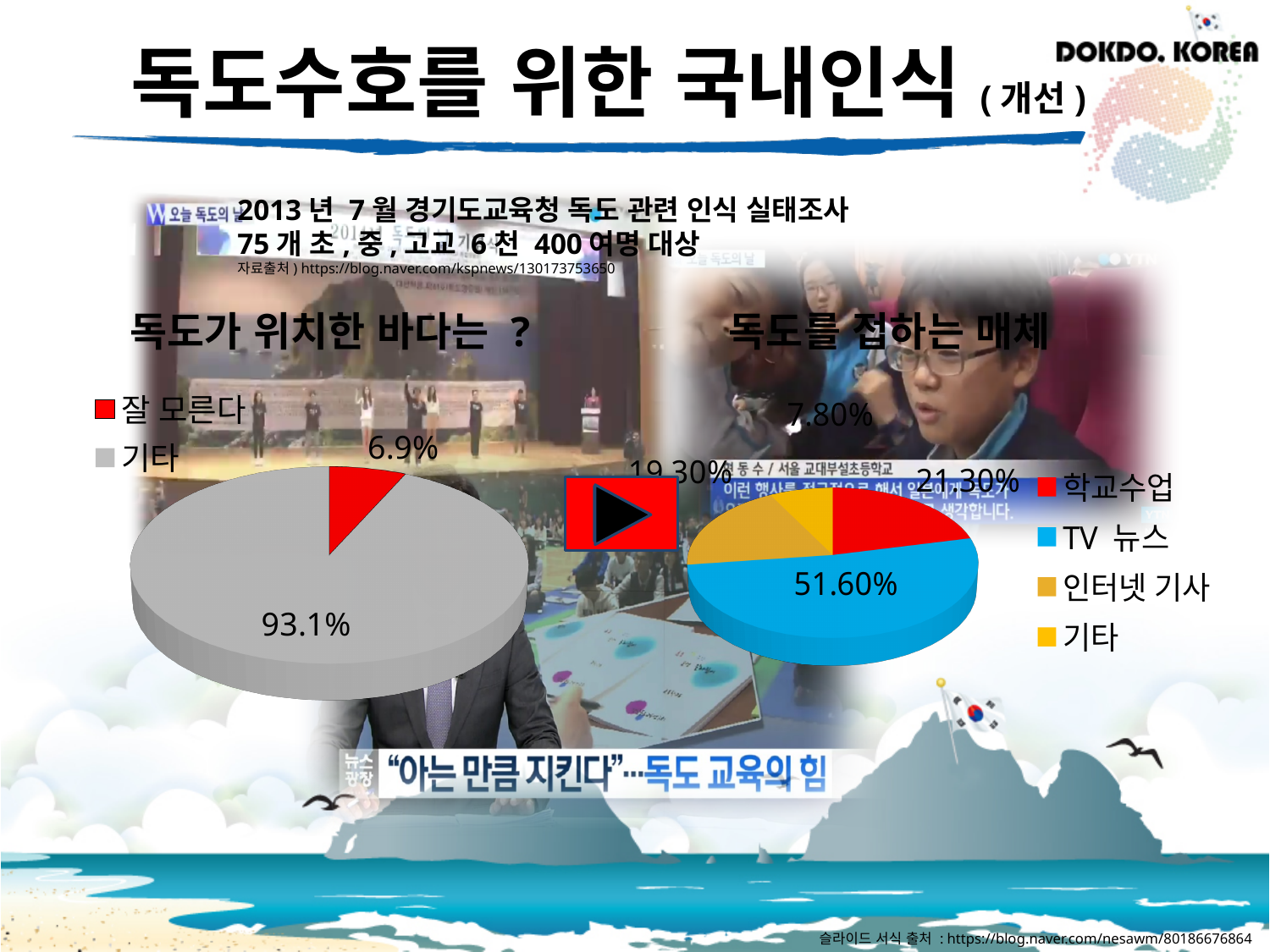
In the right pie chart titled '독도를 접하는 매체', what percentage is shown for '학교수업'? 21.30% In the left pie chart titled '독도가 위치한 바다는 ?', what is the difference between the '기타' and '잘 모른다' shares? 86.2% In the right pie chart titled '독도를 접하는 매체', which category has the smallest share? 기타 In the left pie chart titled '독도가 위치한 바다는 ?', what percentage is shown for '기타'? 93.1% In the right pie chart titled '독도를 접하는 매체', which is larger: '학교수업' or '인터넷 기사'? 학교수업 In the right pie chart titled '독도를 접하는 매체', what percentage is shown for '인터넷 기사'? 19.30% In the right pie chart titled '독도를 접하는 매체', how many categories does the legend list? 4 In the left pie chart titled '독도가 위치한 바다는 ?', how many slices does the pie have? 2 In the left pie chart titled '독도가 위치한 바다는 ?', which category has the largest share? 기타 What type of chart is used for '독도를 접하는 매체'? Pie chart In the left pie chart titled '독도가 위치한 바다는 ?', what percentage is shown for '잘 모른다'? 6.9% In the right pie chart titled '독도를 접하는 매체', what percentage is shown for 'TV 뉴스'? 51.60%